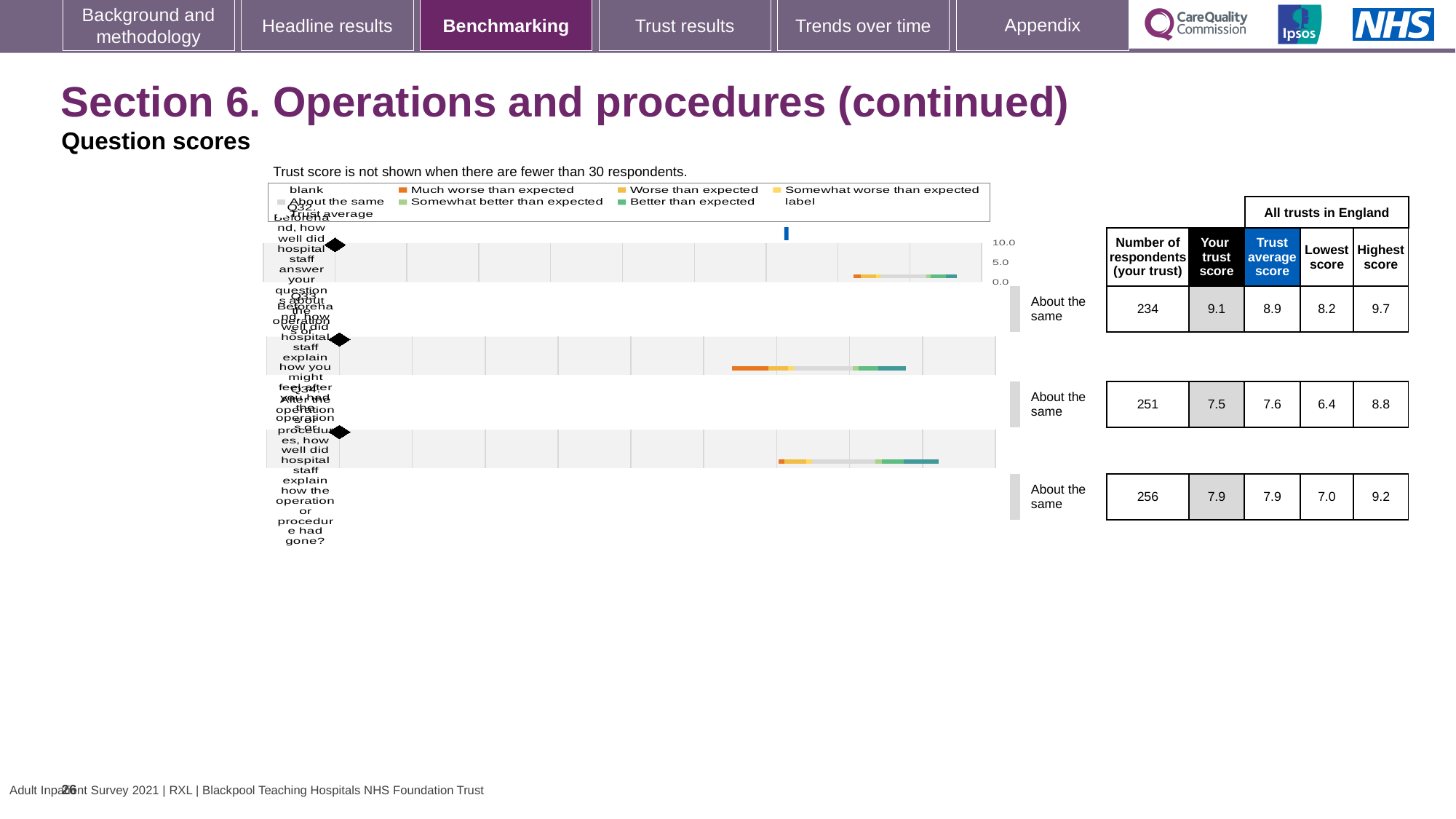
In the table next to the bottom chart, what is the highest score among all trusts in England? 9.2 In the table next to the middle chart, what is the trust average score for all trusts in England? 7.6 Which of the three chart rows in the table has the lowest trust score? the middle chart (7.5) In the table next to the top chart, what is the number of respondents for the trust? 234 Which of the three chart rows in the table has the highest number of respondents? the bottom chart (256) What type of chart is used for the three benchmarking charts on the slide? bar chart In the table next to the middle chart, what is the difference between the highest score and the lowest score? 2.4 What benchmark category is shown beside each of the three charts? About the same In the table next to the top chart, what is the trust score? 9.1 How many benchmarking charts are shown on the slide? 3 What is the maximum value shown on the x axis of the top chart? 10.0 For the top chart's row in the table, which is larger: the trust score or the trust average score? the trust score (9.1)